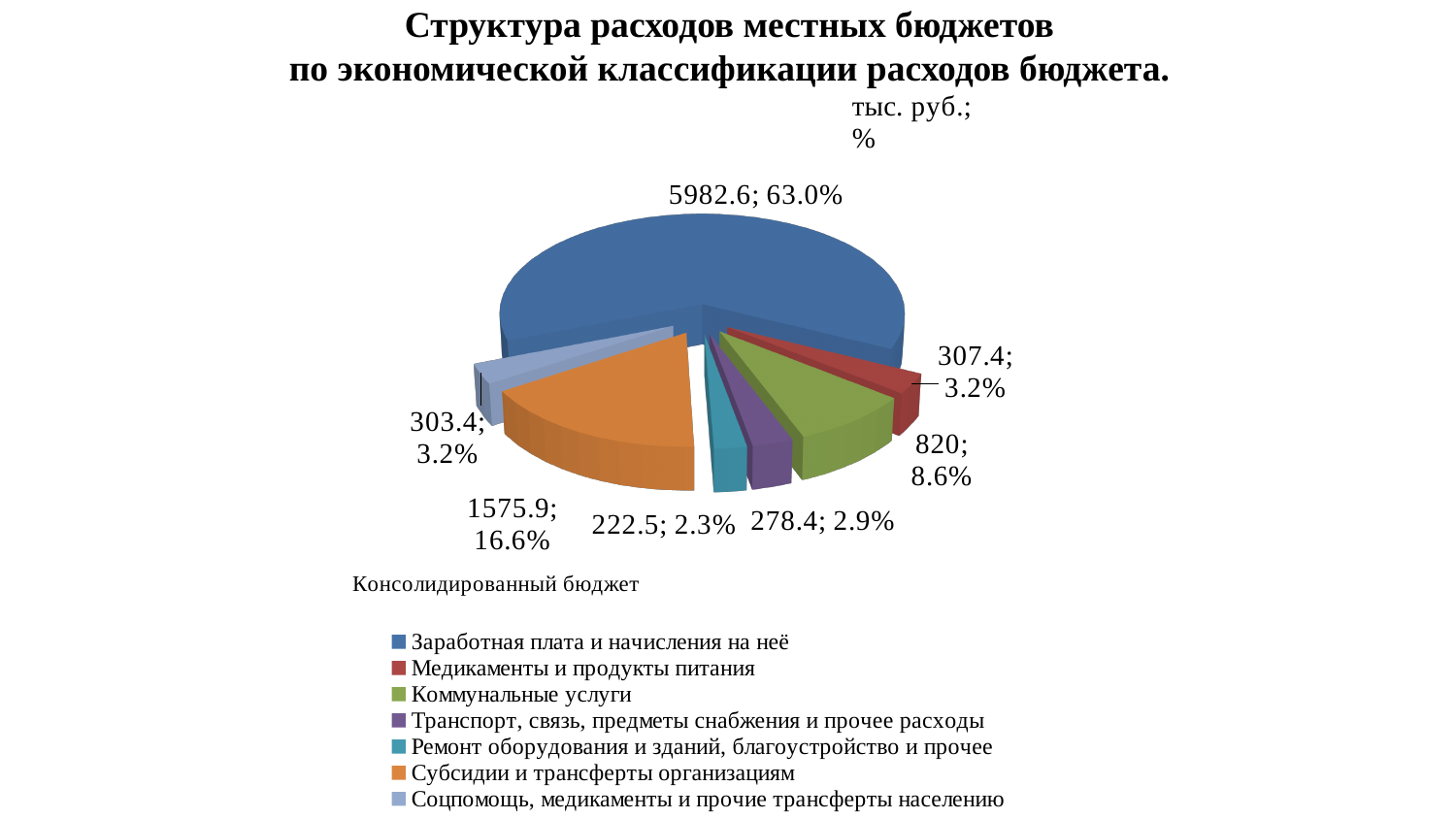
What value is shown for Заработная плата и начисления на неё? 5982.6 What value is shown for Коммунальные услуги? 820 What share of the pie does Субсидии и трансферты организациям represent? 16.6% What share of the pie does Транспорт, связь, предметы снабжения и прочее расходы represent? 2.9% Which is larger: the value for Коммунальные услуги or the value for Медикаменты и продукты питания? Коммунальные услуги What kind of chart is shown on the slide? Pie chart What is the difference between the values for Заработная плата и начисления на неё and Субсидии и трансферты организациям? 4406.7 What value is shown for Ремонт оборудования и зданий, благоустройство и прочее? 222.5 How many slices does the pie chart have? 7 Which category has the smallest slice of the pie? Ремонт оборудования и зданий, благоустройство и прочее Which category has the largest slice of the pie? Заработная плата и начисления на неё What label appears below the pie chart? Консолидированный бюджет